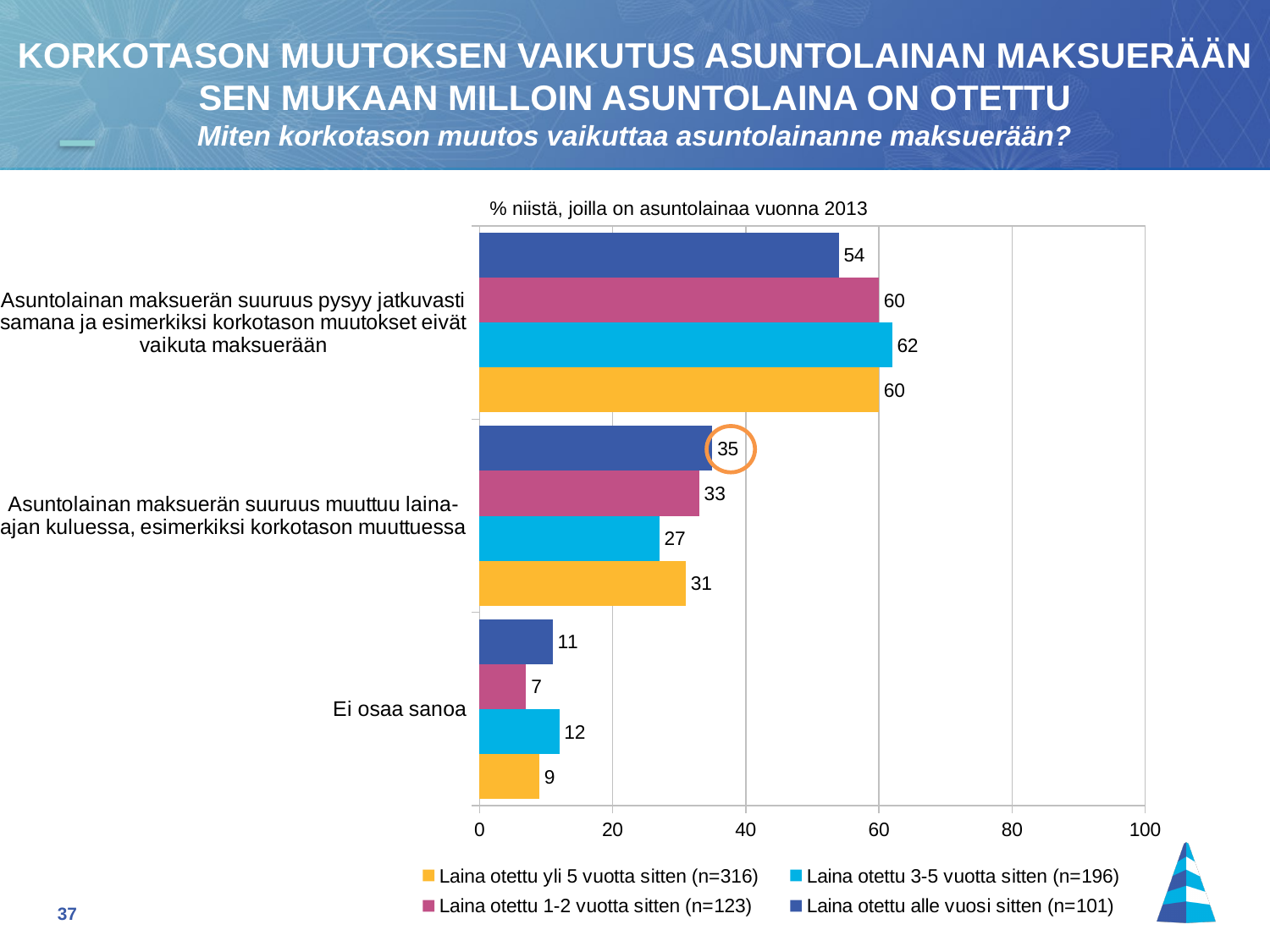
How many series does the legend list? 4 How many categories (response options) are shown on the chart? 3 In the category 'Ei osaa sanoa', which is larger: the value for 'Laina otettu yli 5 vuotta sitten (n=316)' or for 'Laina otettu 3-5 vuotta sitten (n=196)'? Laina otettu 3-5 vuotta sitten (n=196) Is the value for 'Laina otettu alle vuosi sitten (n=101)' in the category 'Asuntolainan maksuerän suuruus pysyy jatkuvasti samana ja esimerkiksi korkotason muutokset eivät vaikuta maksuerään' greater or less than 60? less Which series has the highest value in the category 'Asuntolainan maksuerän suuruus pysyy jatkuvasti samana ja esimerkiksi korkotason muutokset eivät vaikuta maksuerään'? Laina otettu 3-5 vuotta sitten (n=196) What is the value for 'Laina otettu alle vuosi sitten (n=101)' in the category 'Asuntolainan maksuerän suuruus muuttuu laina-ajan kuluessa, esimerkiksi korkotason muuttuessa'? 35 Which series has the lowest value in the category 'Ei osaa sanoa'? Laina otettu 1-2 vuotta sitten (n=123) What is the difference between the values for 'Laina otettu alle vuosi sitten (n=101)' and 'Laina otettu 3-5 vuotta sitten (n=196)' in the category 'Asuntolainan maksuerän suuruus muuttuu laina-ajan kuluessa, esimerkiksi korkotason muuttuessa'? 8 What kind of chart is shown on the slide? bar chart What is the value for 'Laina otettu 1-2 vuotta sitten (n=123)' in the category 'Ei osaa sanoa'? 7 What is the value for 'Laina otettu 3-5 vuotta sitten (n=196)' in the category 'Asuntolainan maksuerän suuruus pysyy jatkuvasti samana ja esimerkiksi korkotason muutokset eivät vaikuta maksuerään'? 62 What is the subtitle text printed above the chart? % niistä, joilla on asuntolainaa vuonna 2013